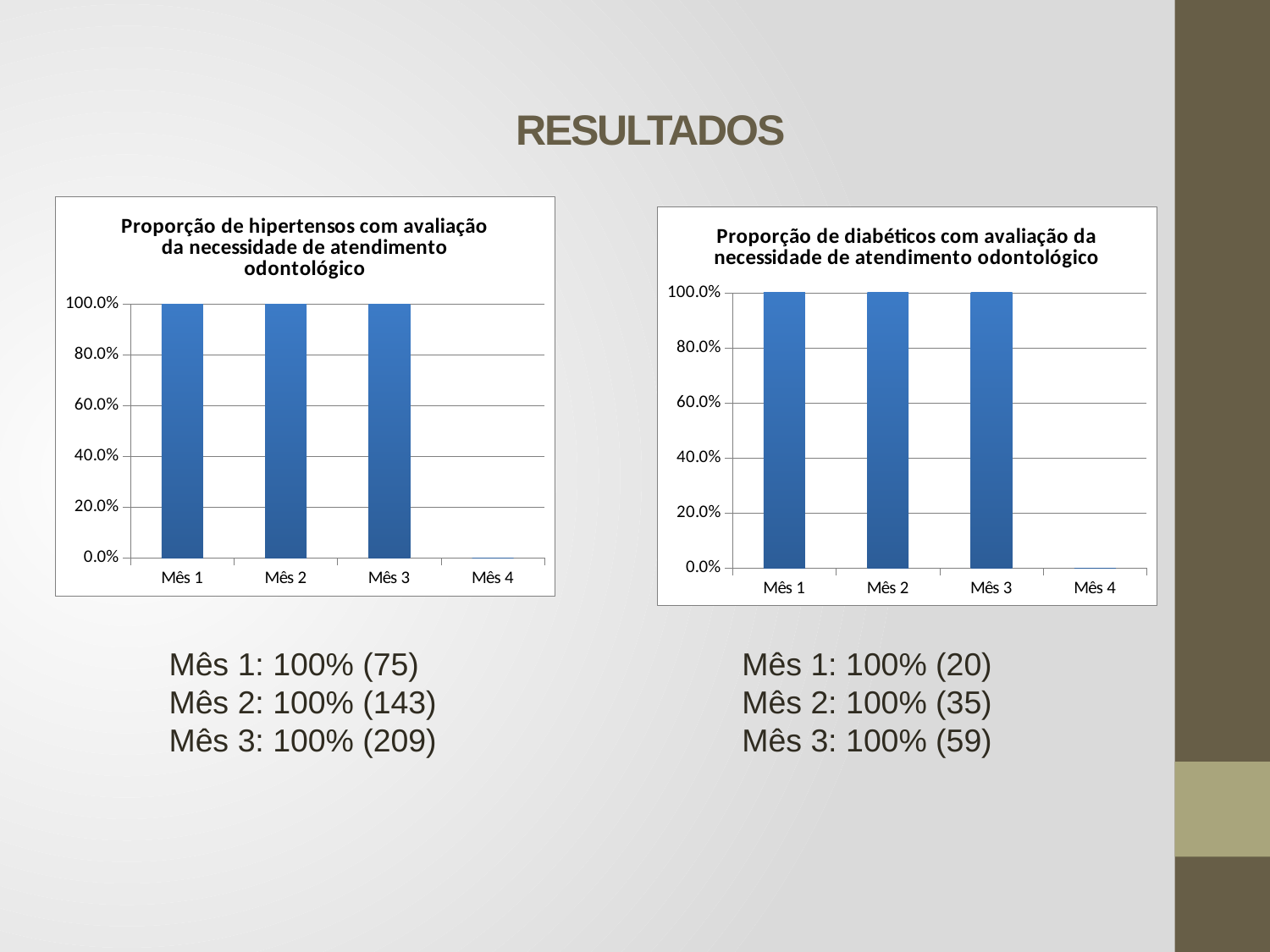
What kind of chart is the 'Proporção de diabéticos com avaliação da necessidade de atendimento odontológico' chart? bar chart How many categories are shown on the x axis of the 'Proporção de diabéticos com avaliação da necessidade de atendimento odontológico' chart? 4 In the 'Proporção de diabéticos com avaliação da necessidade de atendimento odontológico' chart, what is the value for Mês 2? 100.0% In the 'Proporção de diabéticos com avaliação da necessidade de atendimento odontológico' chart, which category has no bar plotted? Mês 4 What is the title of the chart on the left of the slide? Proporção de hipertensos com avaliação da necessidade de atendimento odontológico In the 'Proporção de diabéticos com avaliação da necessidade de atendimento odontológico' chart, is the value for Mês 3 greater or less than 60.0%? greater What kind of chart is the 'Proporção de hipertensos com avaliação da necessidade de atendimento odontológico' chart? bar chart In the 'Proporção de hipertensos com avaliação da necessidade de atendimento odontológico' chart, what is the value for Mês 1? 100.0% In the 'Proporção de hipertensos com avaliação da necessidade de atendimento odontológico' chart, what is the difference between the values for Mês 1 and Mês 2? 0.0% In the 'Proporção de hipertensos com avaliação da necessidade de atendimento odontológico' chart, is the value for Mês 2 greater or less than 80.0%? greater In the 'Proporção de hipertensos com avaliação da necessidade de atendimento odontológico' chart, what is the value for Mês 3? 100.0% How many categories are shown on the x axis of the 'Proporção de hipertensos com avaliação da necessidade de atendimento odontológico' chart? 4